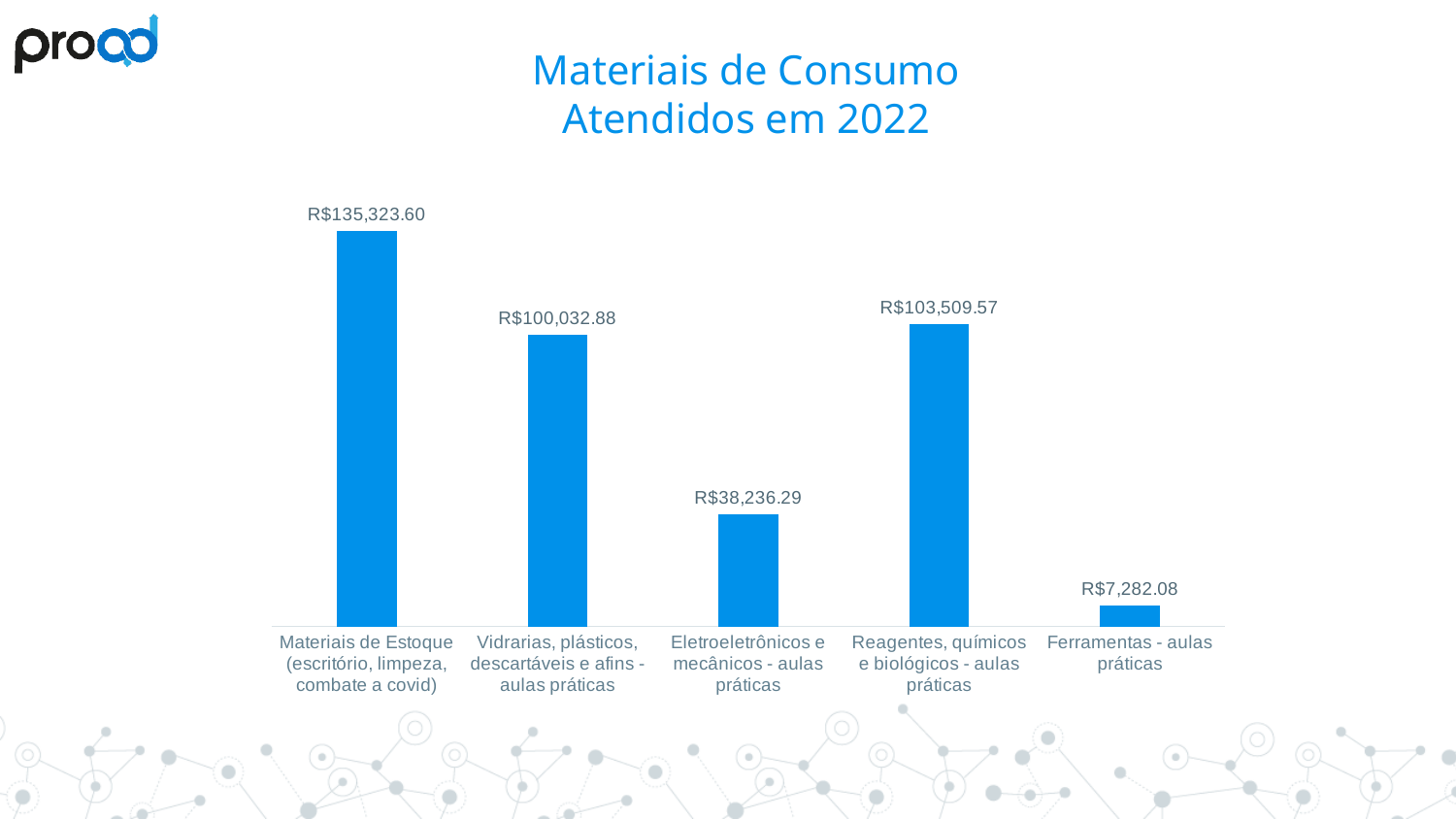
Which is larger, the value for Reagentes, químicos e biológicos or the value for Vidrarias, plásticos, descartáveis e afins? Reagentes, químicos e biológicos What is the difference between Reagentes, químicos e biológicos and Vidrarias, plásticos, descartáveis e afins? R$3,476.69 What is the value for Reagentes, químicos e biológicos - aulas práticas? R$103,509.57 What is the value for Ferramentas - aulas práticas? R$7,282.08 What is the title of the chart? Materiais de Consumo Atendidos em 2022 What is the difference between Materiais de Estoque and Vidrarias, plásticos, descartáveis e afins? R$35,290.72 Which category has the lowest value? Ferramentas - aulas práticas What kind of chart is shown on the slide? Bar chart What is the value for Materiais de Estoque (escritório, limpeza, combate a covid)? R$135,323.60 Which category has the highest value? Materiais de Estoque (escritório, limpeza, combate a covid) How many categories are shown in the chart? 5 What is the value for Eletroeletrônicos e mecânicos - aulas práticas? R$38,236.29